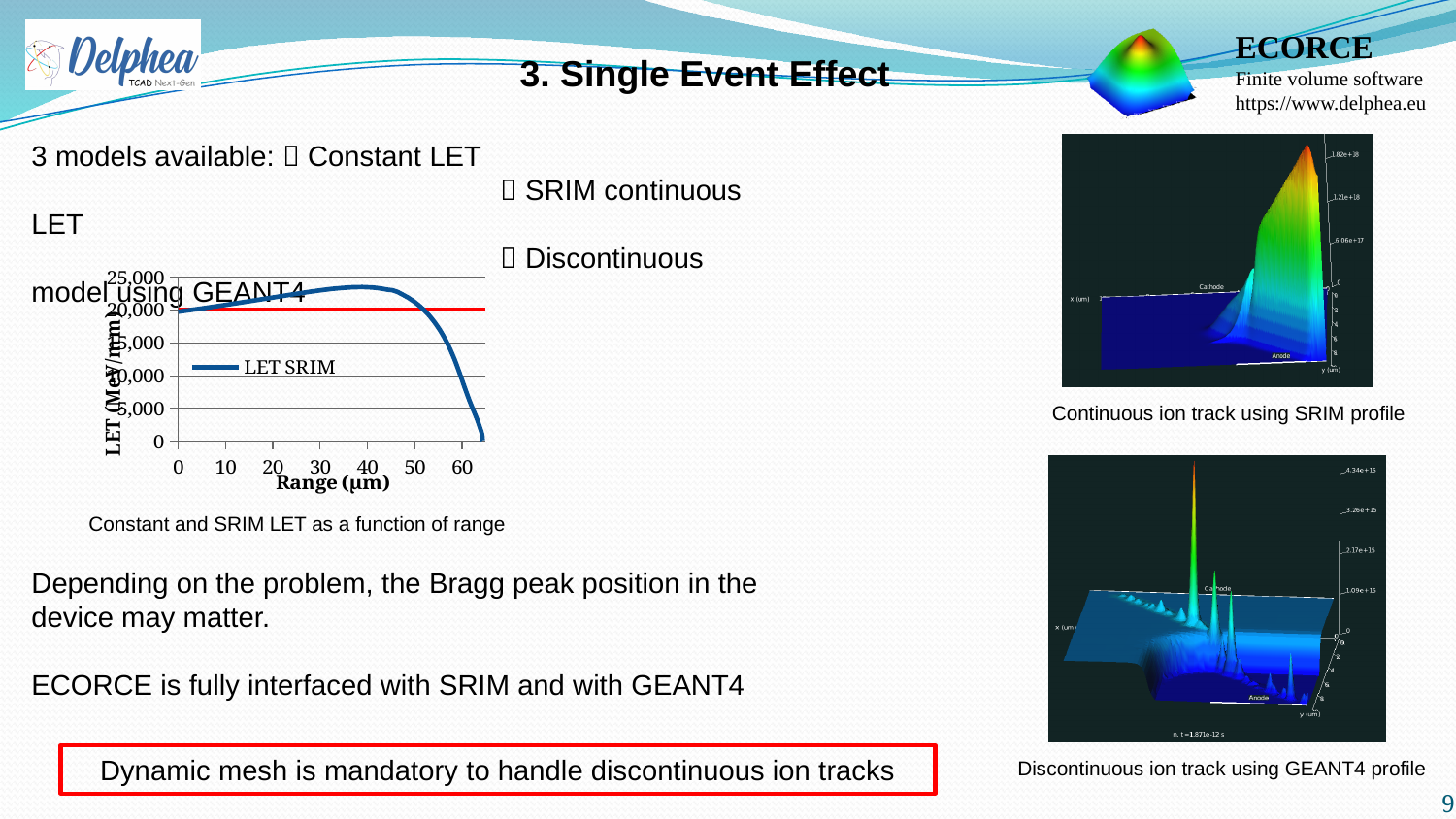
In the LET chart, does the LET SRIM curve rise or fall between a range of 50 µm and 60 µm? fall In the LET chart, is the LET SRIM value at a range of 60 µm greater or less than 20,000? less What is the name of the series listed in the legend of the LET chart? LET SRIM What kind of chart is shown under the heading '3 models available'? line chart In the LET chart, is the LET SRIM value at a range of 20 µm greater or less than 15,000? greater In the LET chart, is the LET SRIM value at a range of 40 µm greater or less than 20,000? greater How many series does the legend of the LET chart list? 1 How many tick labels are shown on the x axis of the LET chart? 7 What is the highest tick value shown on the y axis of the LET chart? 25,000 What caption appears below the LET chart? Constant and SRIM LET as a function of range